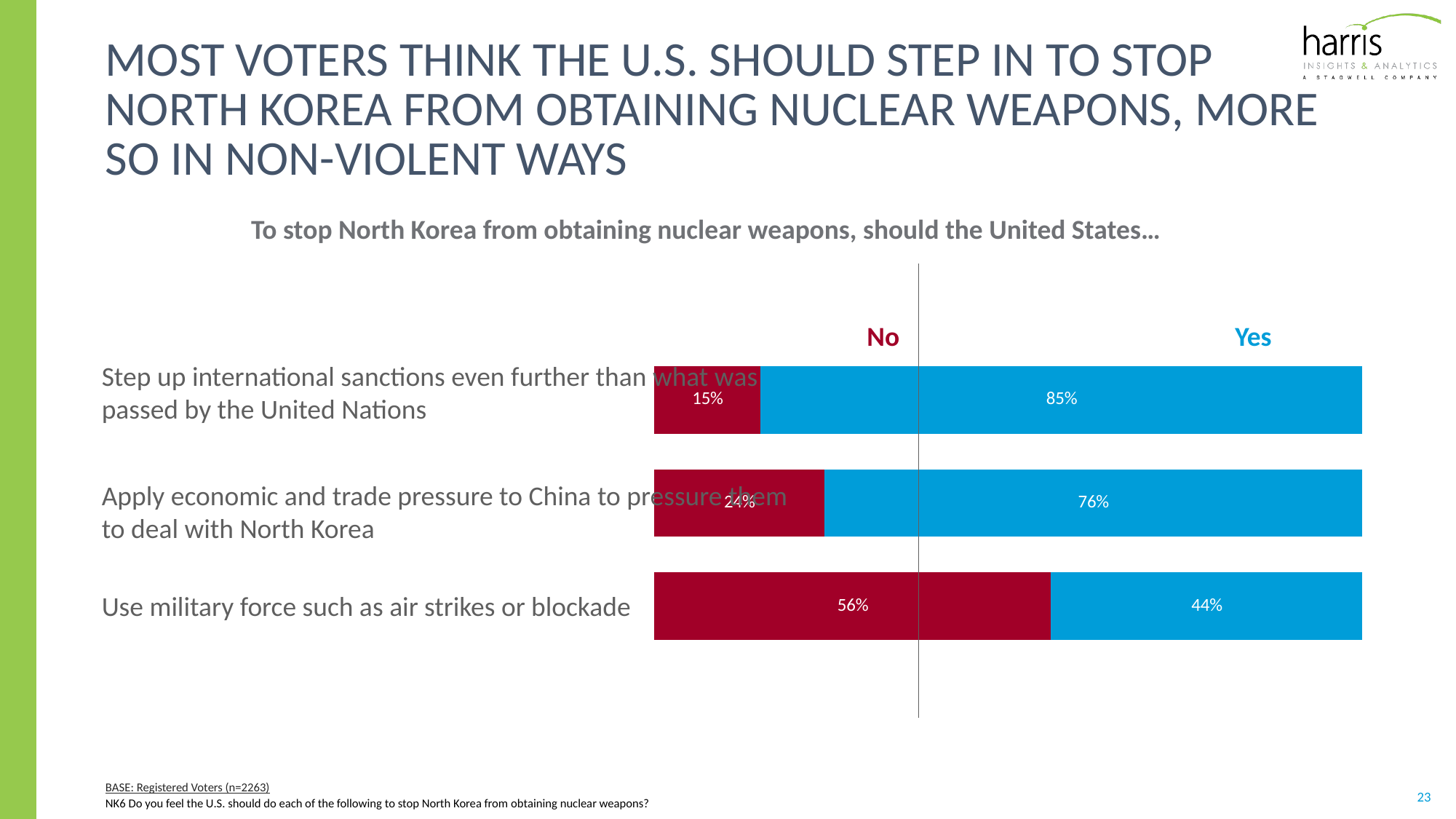
What kind of chart is shown on the slide? Bar chart How many response series does the chart show? 2 Which is larger: the No percentage for applying economic and trade pressure to China or the No percentage for using military force? Use military force such as air strikes or blockade Which option has the highest Yes percentage? Step up international sanctions even further than what was passed by the United Nations What percentage of voters say Yes to stepping up international sanctions even further than what was passed by the United Nations? 85% What percentage of voters say Yes to applying economic and trade pressure to China to pressure them to deal with North Korea? 76% How many options are shown in the chart? 3 What percentage of voters say No to using military force such as air strikes or blockade? 56% What is the difference between the Yes and No percentages for using military force such as air strikes or blockade? 12% Which option has the lowest Yes percentage? Use military force such as air strikes or blockade What colour represents the Yes responses in the chart? Blue What percentage of voters say No to stepping up international sanctions even further than what was passed by the United Nations? 15%